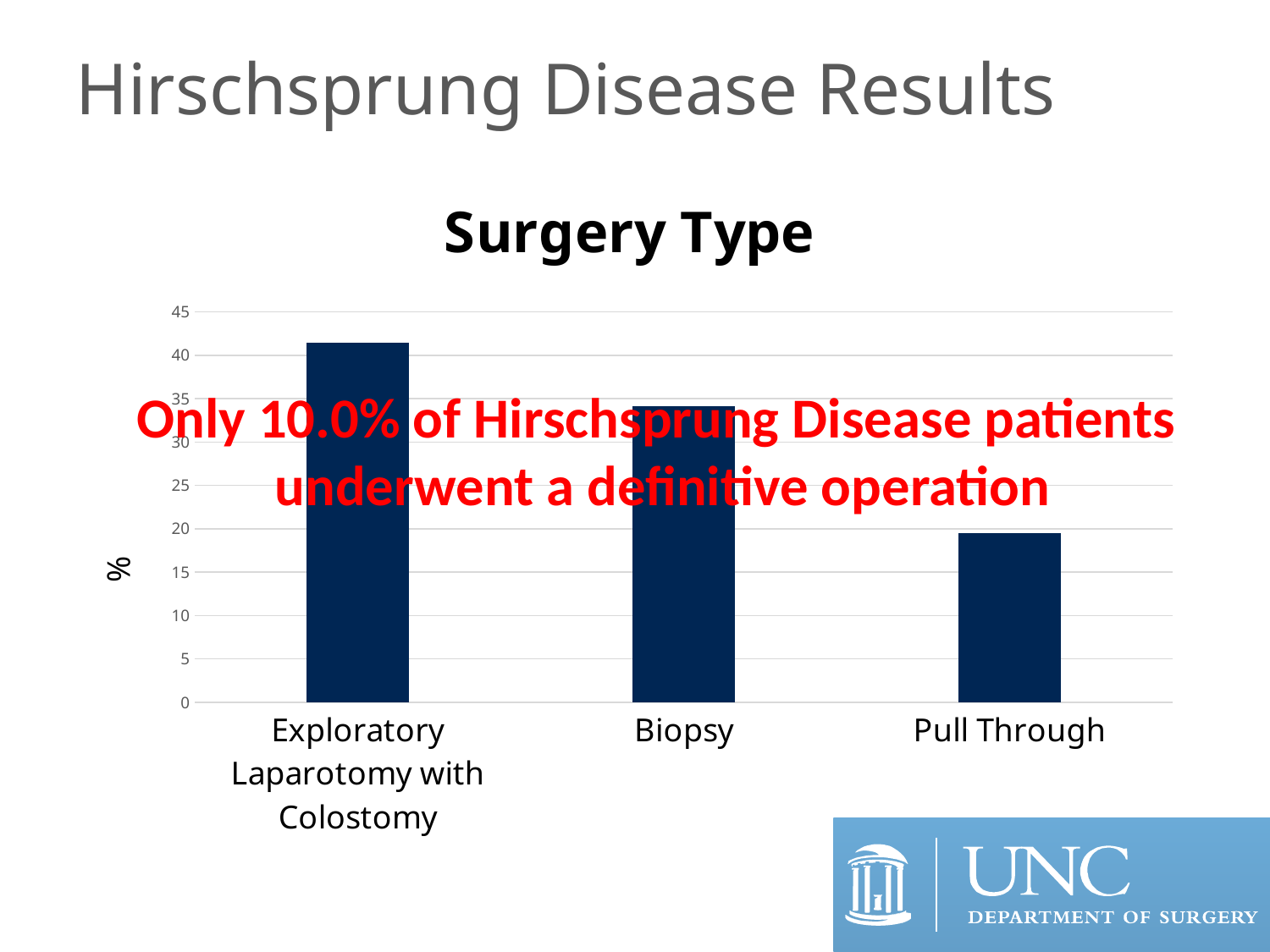
Is the value for Exploratory Laparotomy with Colostomy greater or less than 40? greater What is the label on the vertical axis of the chart? % Which is larger, the value for Exploratory Laparotomy with Colostomy or the value for Biopsy? Exploratory Laparotomy with Colostomy Which surgery type has the highest value? Exploratory Laparotomy with Colostomy What kind of chart is shown on the slide? bar chart Is the value for Biopsy greater or less than 30? greater Which surgery type has the lowest value? Pull Through What is the title of the chart? Surgery Type How many surgery types are plotted in the chart? 3 Do the values rise or fall moving from left to right along the x axis? fall Which is larger, the value for Biopsy or the value for Pull Through? Biopsy